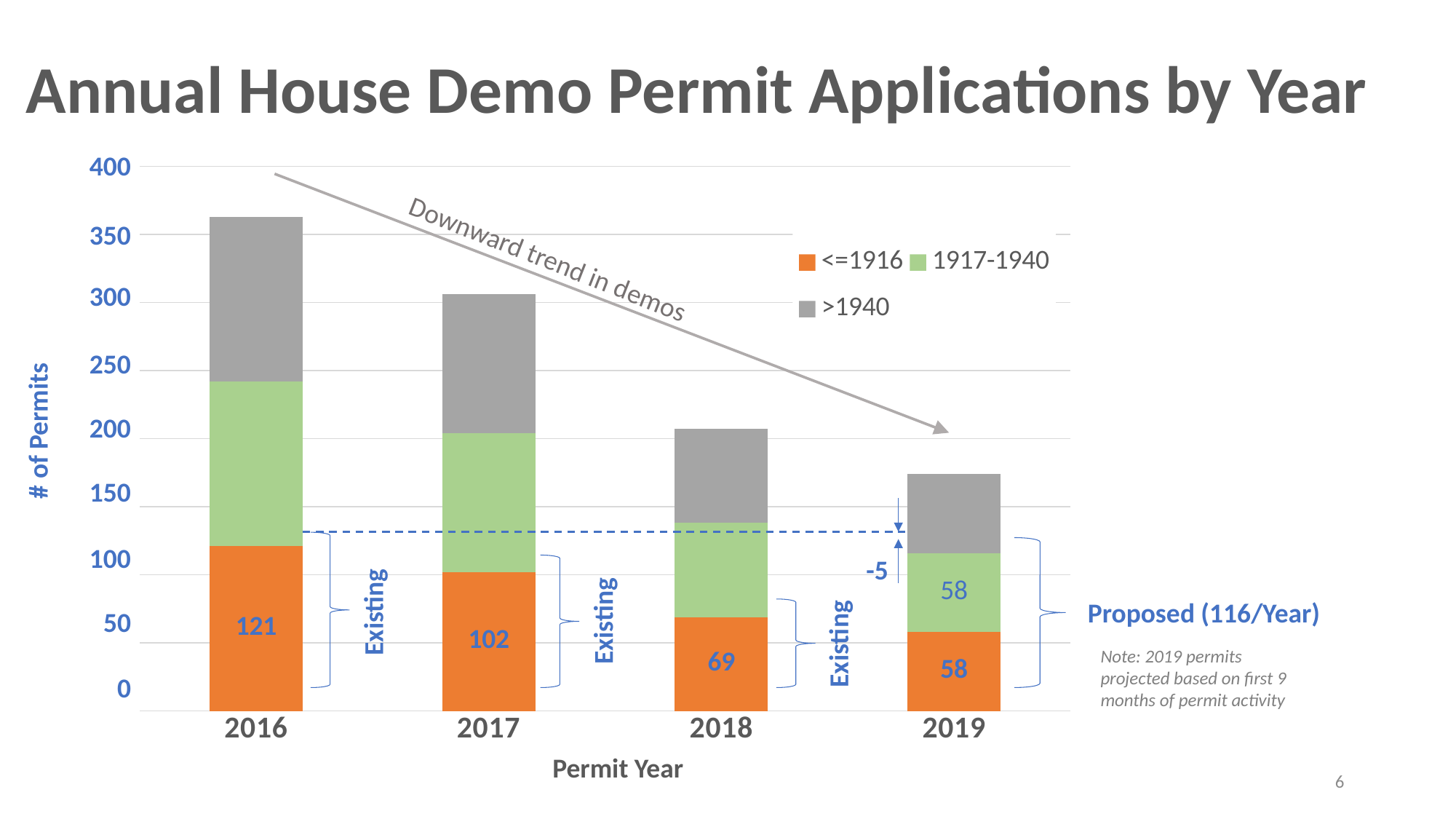
Which is larger, the <=1916 value for 2017 or for 2018? 2017 Is the total height of the 2016 bar greater or less than 350? greater Is the total height of the 2019 bar greater or less than 200? less What is the value for the <=1916 series in 2018? 69 Which year has the lowest value for the <=1916 series? 2019 What is the value for the 1917-1940 series in 2019? 58 Which year has the highest value for the <=1916 series? 2016 How many series does the legend list? 3 What is the value for the <=1916 series in 2016? 121 How many years are shown on the x axis? 4 Do the total bar heights rise or fall from 2016 to 2019? fall What is the difference between the <=1916 values for 2016 and 2017? 19